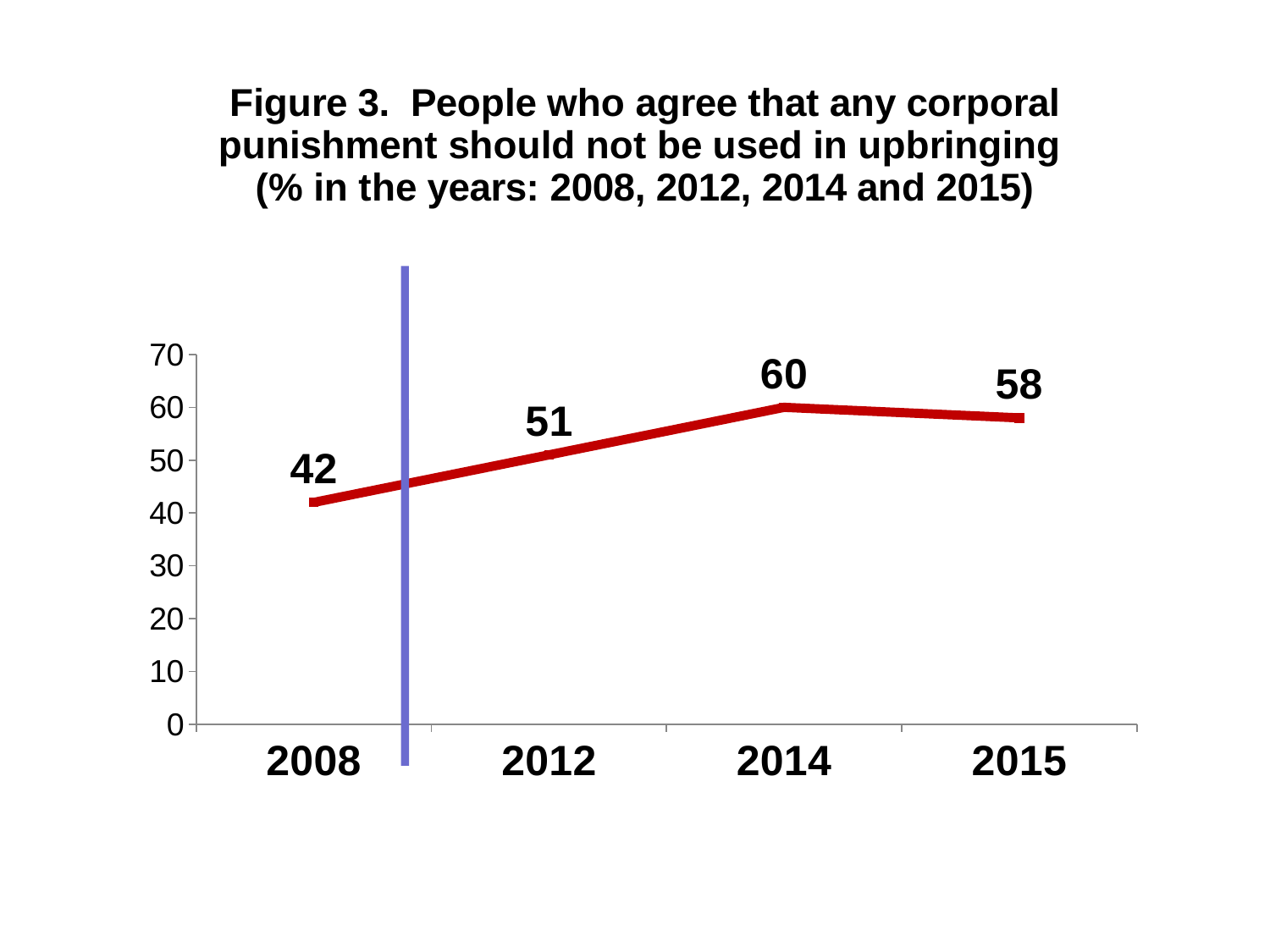
What is the difference between the values for 2014 and 2015? 2 Does the value rise or fall between 2014 and 2015? Fall In which year was the share of people agreeing highest? 2014 How many years are plotted on the chart? 4 What is the value plotted for 2014? 60 What percentage of people agreed that any corporal punishment should not be used in upbringing in 2008? 42 Which year has the larger value, 2012 or 2015? 2015 In which year was the share of people agreeing lowest? 2008 What kind of chart is shown on the slide? Line chart What is the value plotted for 2015? 58 What is the value plotted for 2012? 51 By how many percentage points did the value change from 2008 to 2014? 18